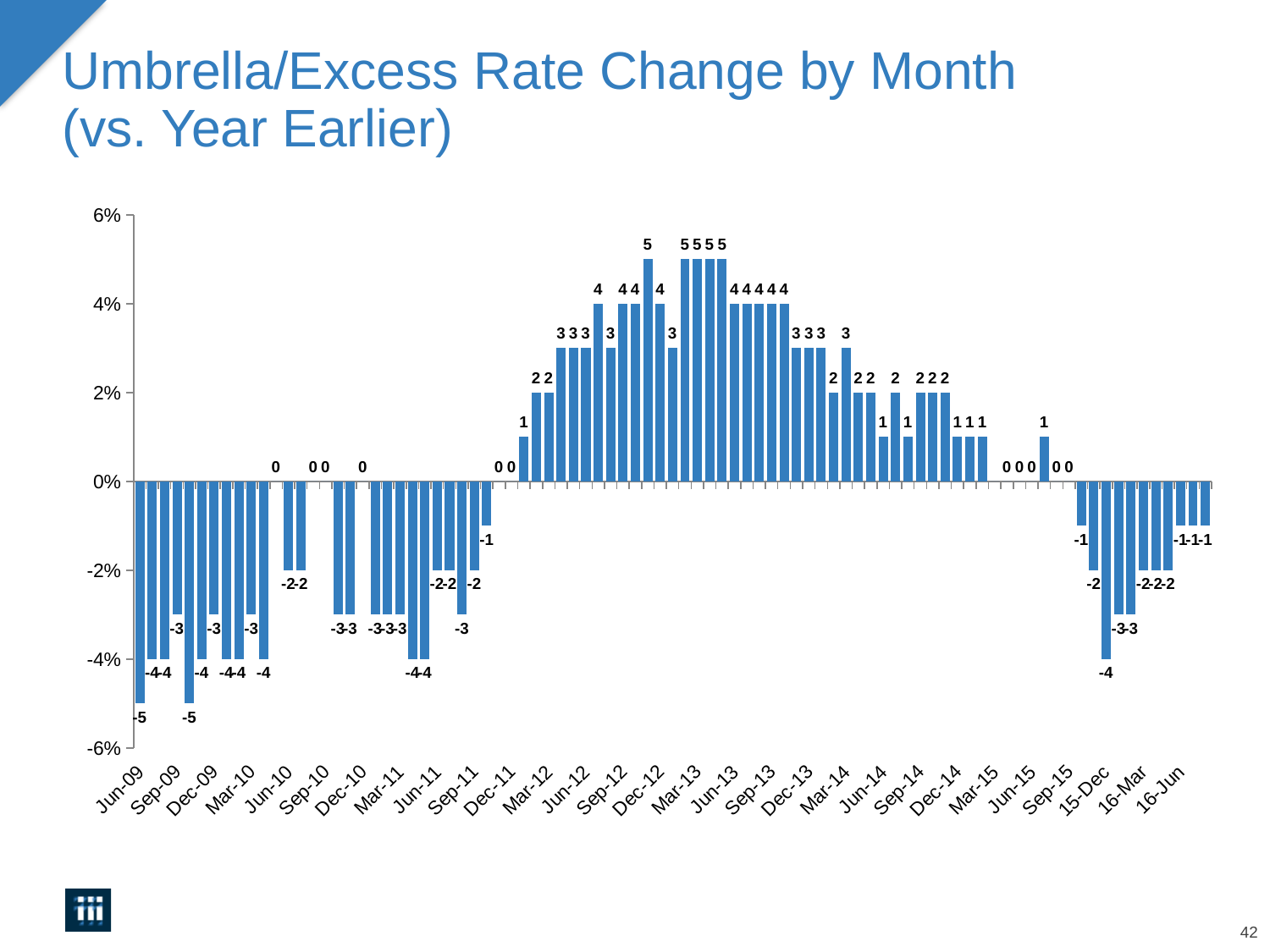
What is the value for 16-Jun, the last bar in the chart? -1 What is the maximum value shown on the vertical axis? 6% Do the values generally rise or fall from Mar-13 to Mar-15? fall Which is larger, the value for Jun-09 or the value for 16-Jun? 16-Jun Do the values generally rise or fall from Jun-09 to Mar-13? rise What is the difference between the highest data label (5) and the lowest data label (-5) in the chart? 10 Is the value for Jun-09 greater or less than -4%? less What is the highest data label value shown in the chart? 5 What is the value for Jun-09, the first bar in the chart? -5 What type of chart is shown on the slide? Bar chart What is the lowest data label value shown in the chart? -5 What is the title of the chart? Umbrella/Excess Rate Change by Month (vs. Year Earlier)